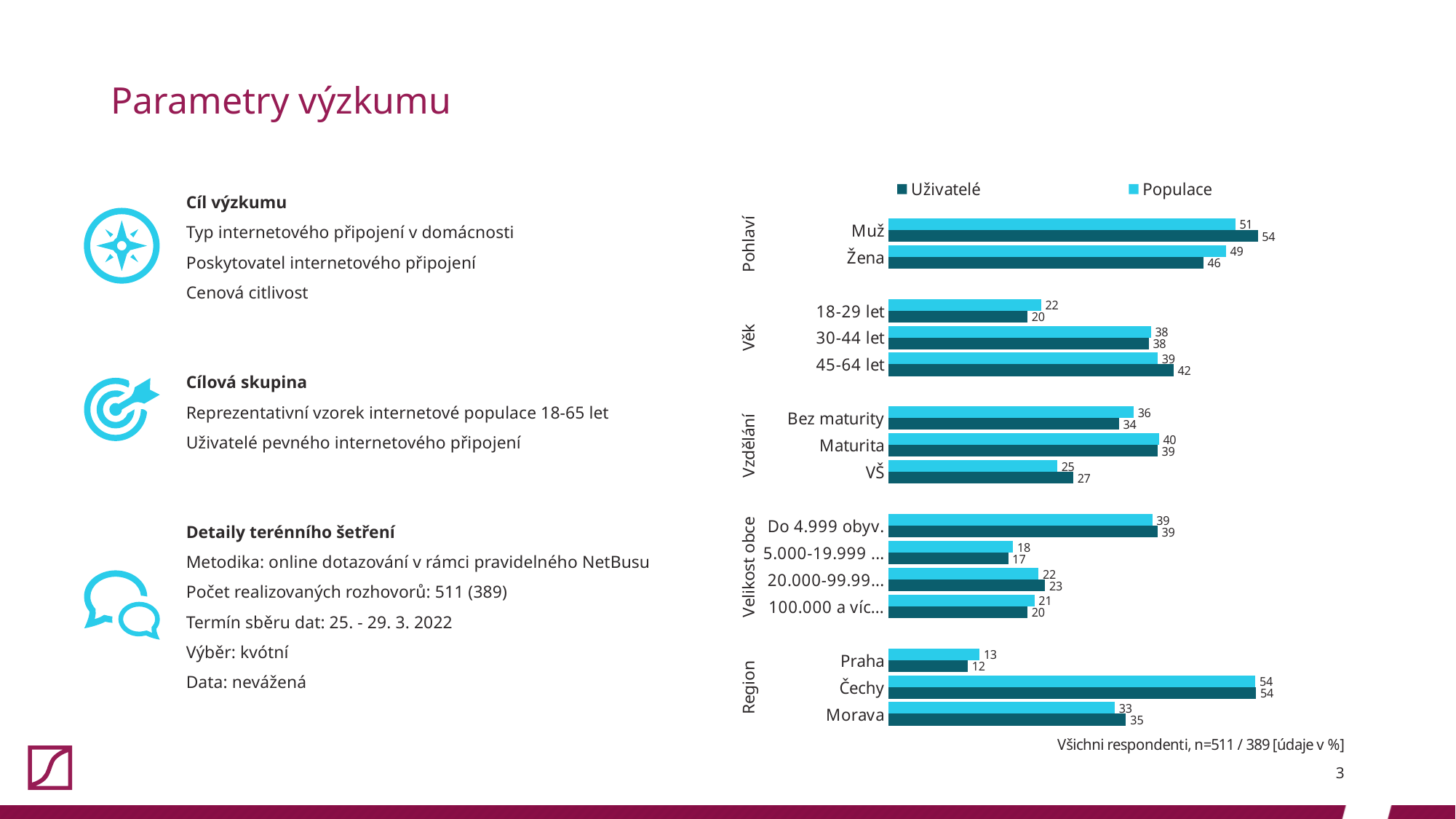
How many series does the chart legend list? 2 What is the difference between the Uživatelé and Populace values for Muž? 3 Which is larger for VŠ: the Uživatelé value or the Populace value? Uživatelé What is the Uživatelé value for 45-64 let? 42 What type of chart is shown on the slide? bar chart What is the Populace value for Bez maturity? 36 What is the Uživatelé value for Praha? 12 Which region category has the highest Populace value? Čechy What is the Populace value for Žena? 49 How many categories are plotted in the chart? 15 What is the Uživatelé value for Muž? 54 Which category has the lowest Uživatelé value? Praha